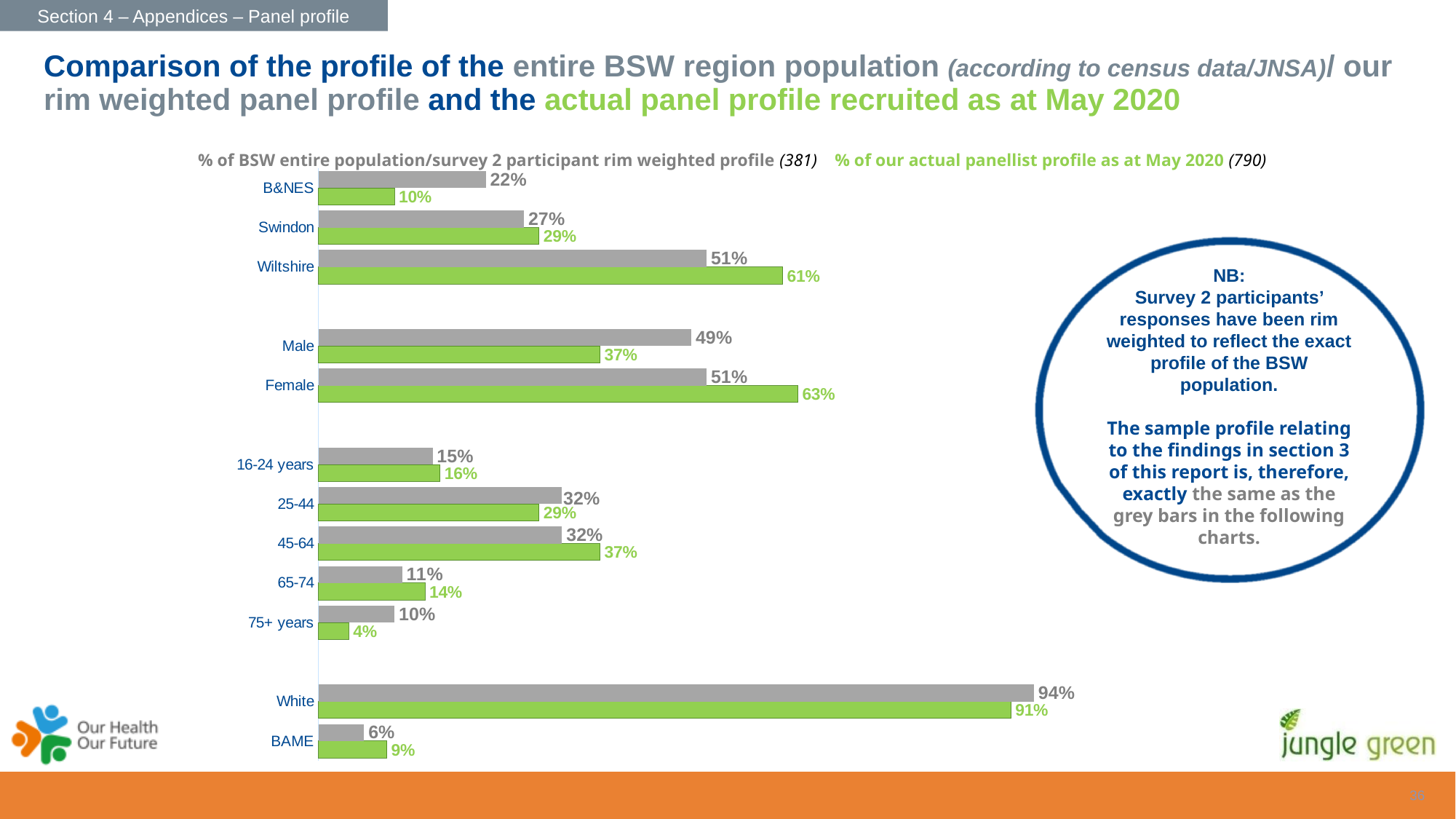
What kind of chart is shown on the slide? Bar chart What is the value for Male in the '% of BSW entire population/survey 2 participant rim weighted profile' series? 49% Which category has the lowest value in the '% of our actual panellist profile as at May 2020' series? 75+ years What is the difference between the two series' values for B&NES? 12% How many categories are shown on the chart? 12 How many series does the legend list? 2 Which category has the highest value in the '% of BSW entire population/survey 2 participant rim weighted profile' series? White What is the value for 75+ years in the '% of our actual panellist profile as at May 2020' series? 4% What is the difference between the two series' values for Female? 12% What is the value for Wiltshire in the '% of our actual panellist profile as at May 2020' series? 61% What colour are the bars for the '% of our actual panellist profile as at May 2020' series? Green For Swindon, which series has the larger value? % of our actual panellist profile as at May 2020